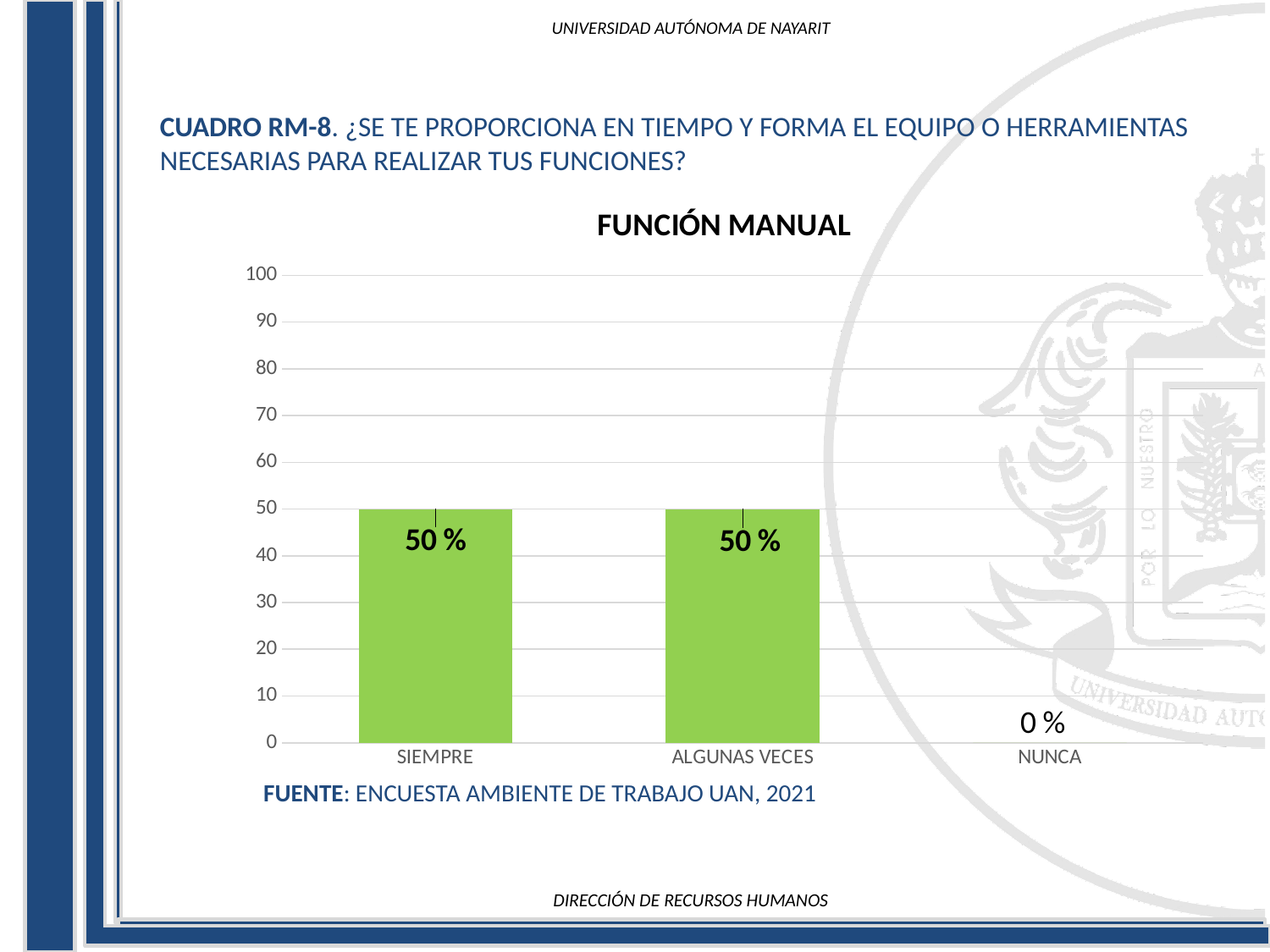
What is the value for SIEMPRE? 50 % Which is larger, the value for ALGUNAS VECES or the value for NUNCA? ALGUNAS VECES What is the title of the chart? FUNCIÓN MANUAL What is the value for ALGUNAS VECES? 50 % What is the highest value shown on the y axis? 100 What is the difference between the values for SIEMPRE and NUNCA? 50 % What colour are the bars in the chart? green Is the value for SIEMPRE greater or less than 40? greater What is the value for NUNCA? 0 % Which category has the lowest value? NUNCA What kind of chart is shown on the slide? bar chart How many categories are shown on the x axis? 3